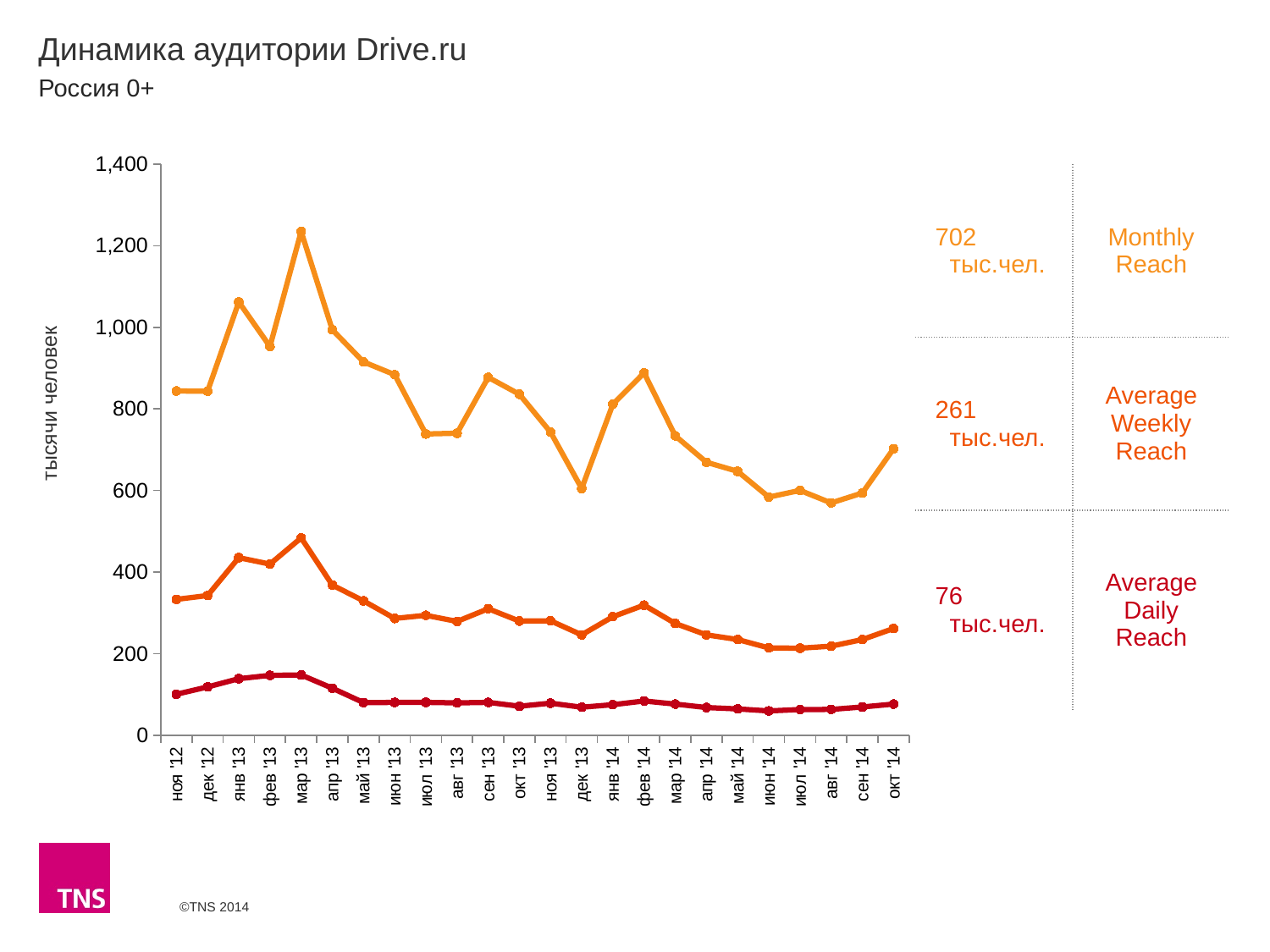
In which month does the Monthly Reach line reach its highest point? мар '13 Is the Monthly Reach value for дек '13 greater or less than 800? less What is the Monthly Reach value shown for окт '14? 702 тыс.чел. Is the Monthly Reach value for мар '13 greater or less than 1,000? greater What is the Average Weekly Reach value shown for окт '14? 261 тыс.чел. What is the Average Daily Reach value shown for окт '14? 76 тыс.чел. How many series are shown on the chart? 3 What is the difference between the Monthly Reach and Average Weekly Reach values shown for окт '14? 441 тыс.чел. What kind of chart is shown on the slide? line chart How many months are plotted along the x axis? 24 In which month does the Average Weekly Reach line reach its highest point? мар '13 Which is higher for Monthly Reach: янв '13 or фев '13? янв '13